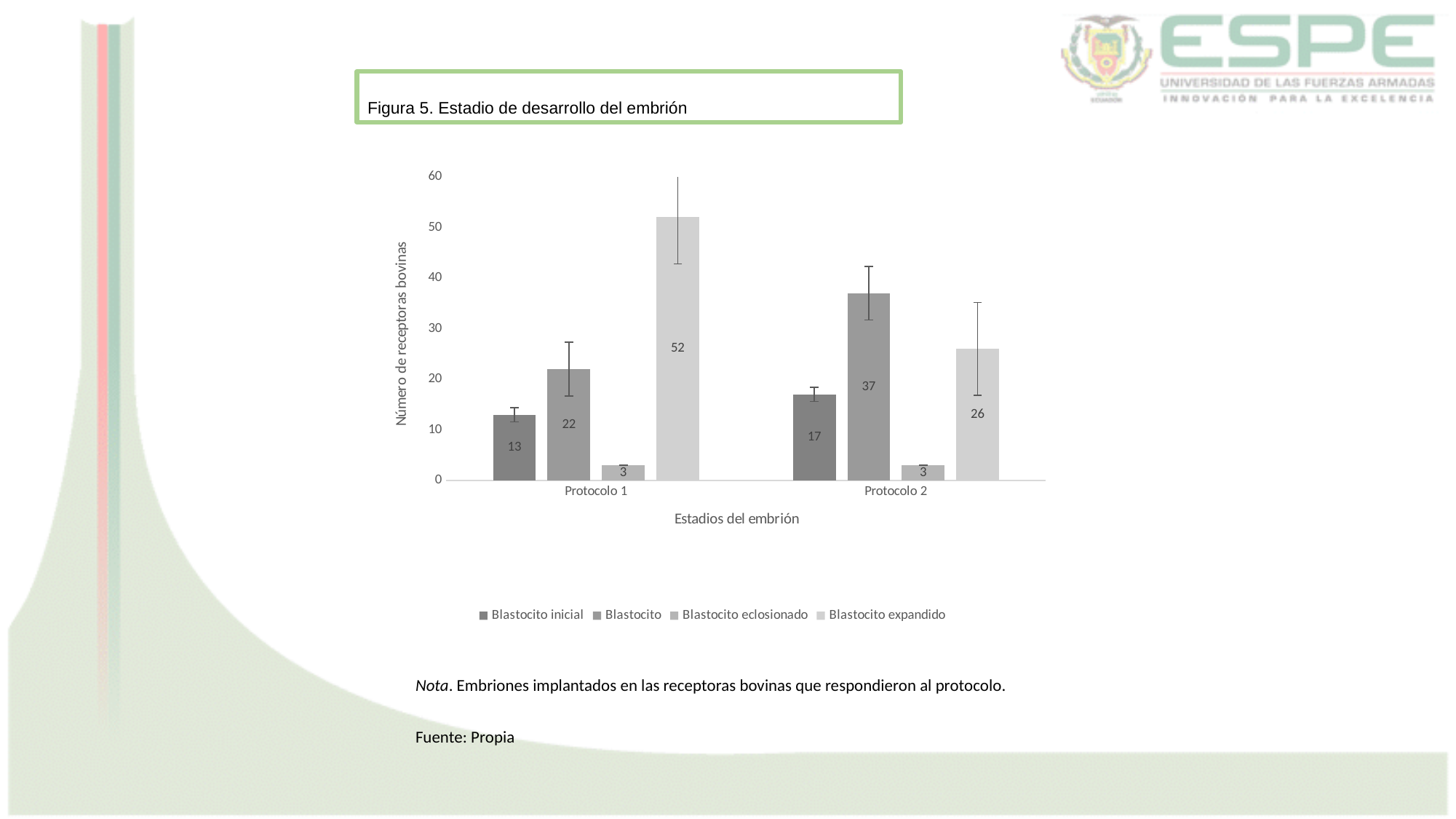
How many series does the legend list? 4 Which series has the highest value in Protocolo 1? Blastocito expandido What is the value for Blastocito in Protocolo 2? 37 What is the value for Blastocito eclosionado in Protocolo 2? 3 Is the value for Blastocito expandido in Protocolo 1 greater or less than 50? greater What is the label of the y axis? Número de receptoras bovinas What is the value for Blastocito expandido in Protocolo 1? 52 What kind of chart is shown? Bar chart Which series has the lowest value in Protocolo 2? Blastocito eclosionado What is the difference between Blastocito expandido in Protocolo 1 and Blastocito expandido in Protocolo 2? 26 Which is larger: Blastocito in Protocolo 1 or Blastocito in Protocolo 2? Blastocito in Protocolo 2 What is the value for Blastocito inicial in Protocolo 1? 13